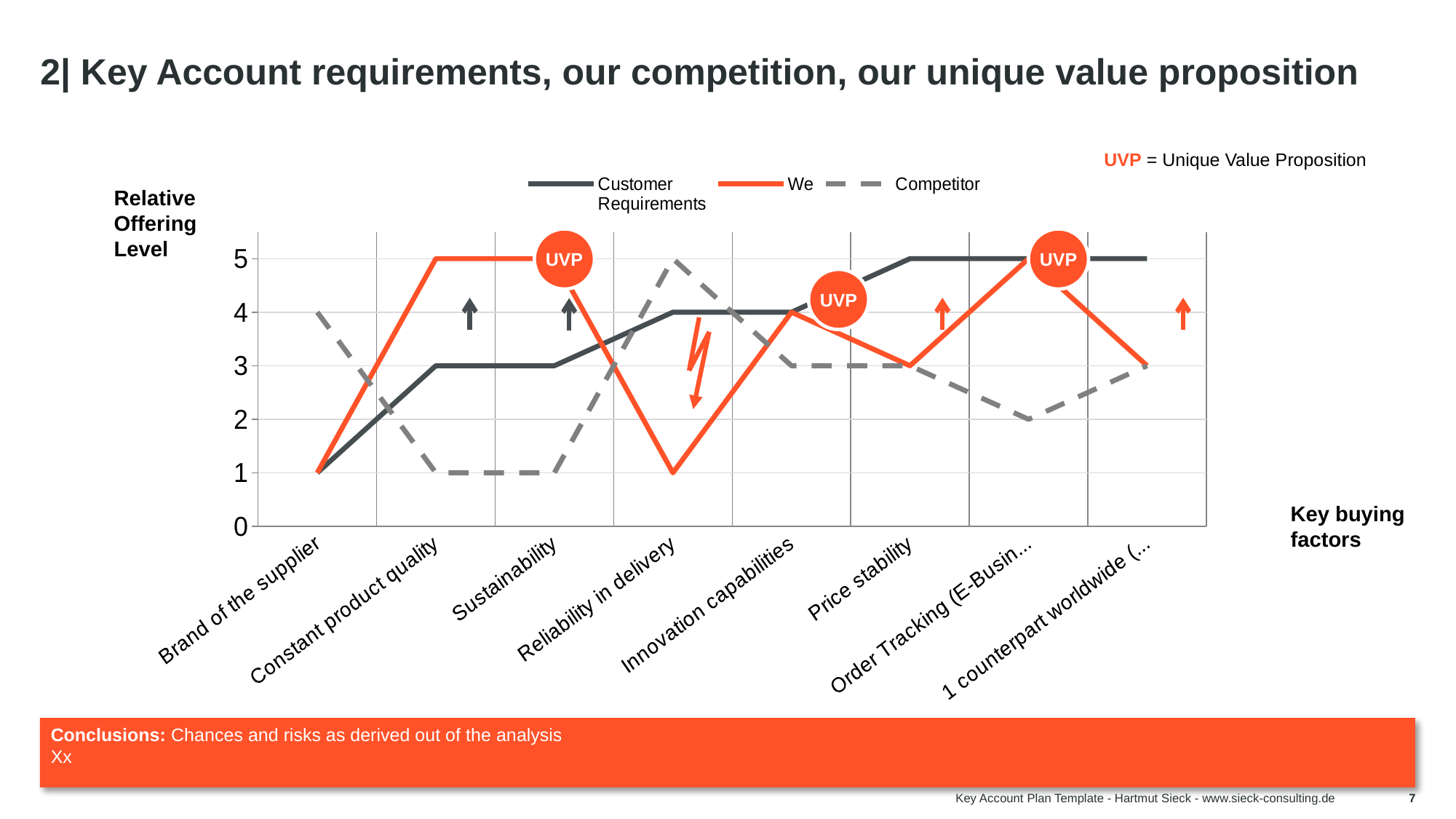
How many series does the legend list? 3 How many key buying factors are plotted along the x axis? 8 Which series is drawn with a dashed line? Competitor What is the value of the We series for Reliability in delivery? 1 What is the value of the Customer Requirements series for Price stability? 5 Does the Customer Requirements series rise or fall from Brand of the supplier to Price stability? Rise For which key buying factor does the Competitor series reach its highest value? Reliability in delivery Which is larger for Constant product quality: the We value or the Competitor value? We What is the value of the Competitor series for Order Tracking? 2 What is the difference between the We value and the Competitor value for Sustainability? 4 What kind of chart is shown on the slide? Line chart What is the value of the Competitor series for Brand of the supplier? 4